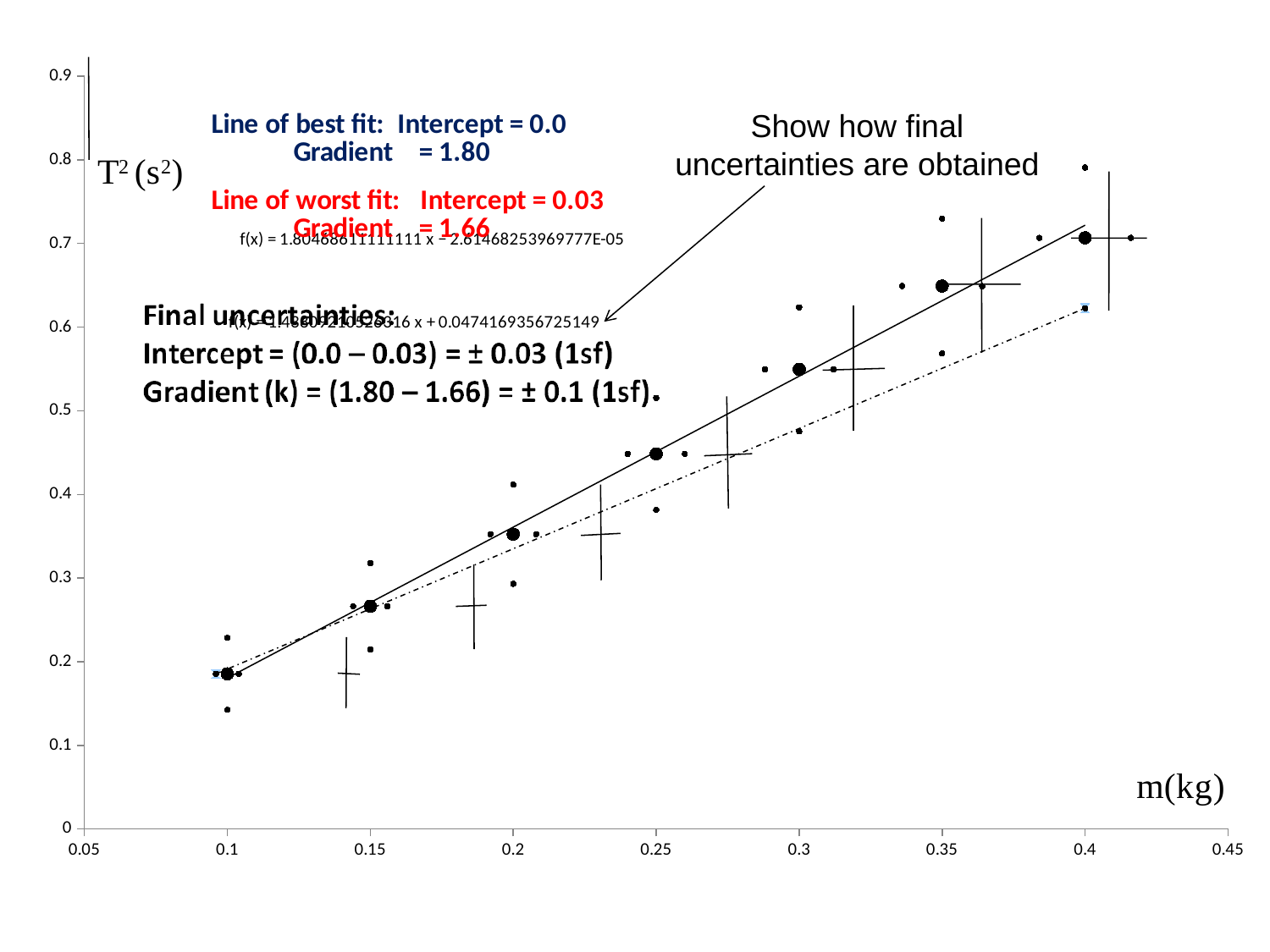
Is the T² value at m = 0.3 greater or less than 0.5? greater What is the label on the x axis of the chart? m(kg) At which value of m is the plotted T² value highest? 0.4 Do the plotted T² values rise or fall as m increases along the x axis? Rise Is the T² value at m = 0.4 greater or less than 0.6? greater Is the T² value at m = 0.2 greater or less than 0.4? less Which has the larger T² value: the point at m = 0.3 or the point at m = 0.2? m = 0.3 What is the label on the y axis of the chart? T² (s²) How many large data points are plotted on the chart? 7 At which value of m is the plotted T² value lowest? 0.1 What kind of chart is shown on the slide? Scatter chart